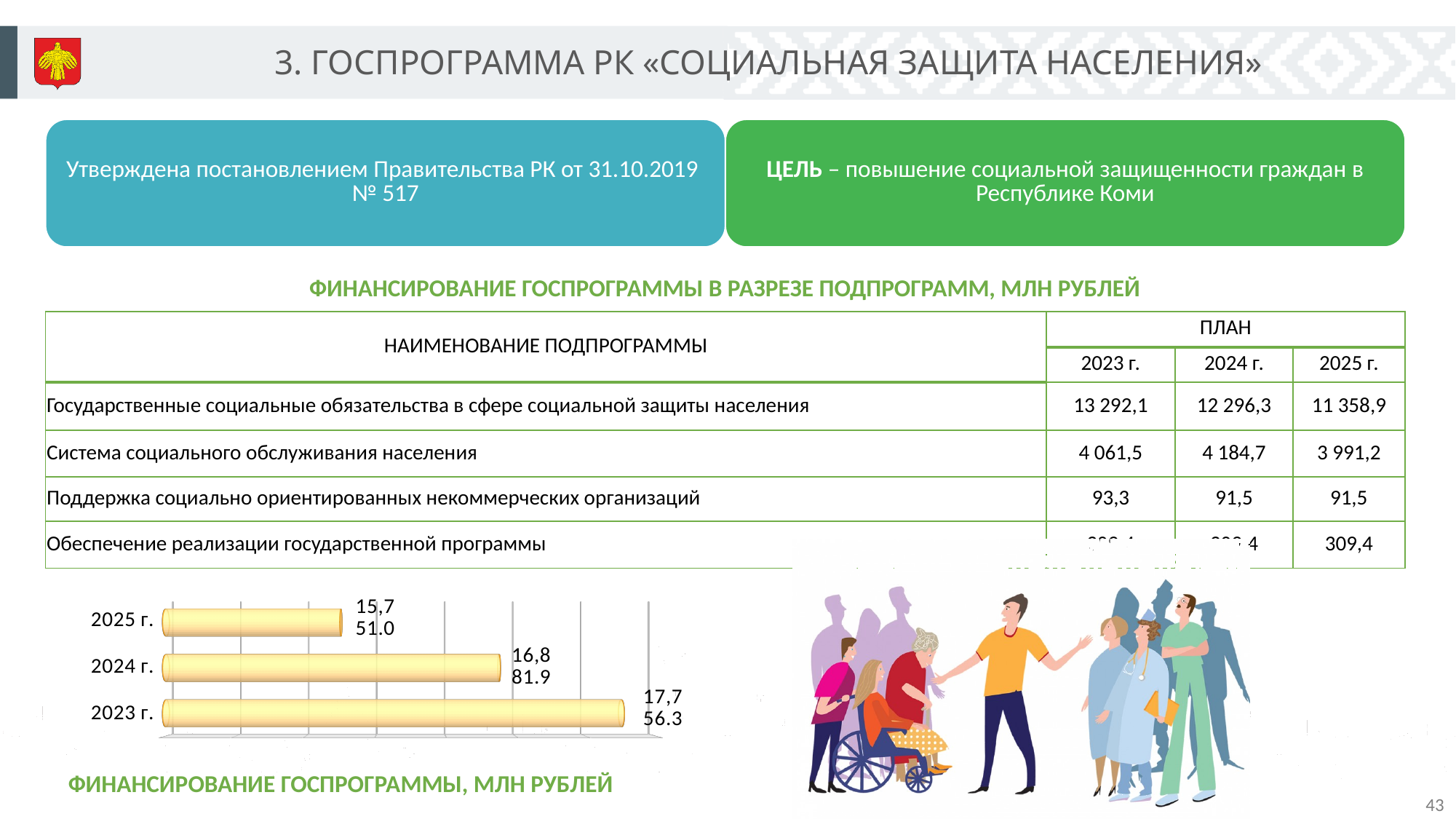
What is the title of the bar chart? ФИНАНСИРОВАНИЕ ГОСПРОГРАММЫ, МЛН РУБЛЕЙ Are the bars in the chart horizontal or vertical? Horizontal Which year has the shortest bar in the chart? 2025 г. Which bar is longer in the chart: 2023 г. or 2024 г.? 2023 г. Which year is listed at the top of the bar chart? 2025 г. What kind of chart is shown at the bottom left of the slide? Bar chart Which year has the longest bar in the chart? 2023 г. Which bar is longer in the chart: 2024 г. or 2025 г.? 2024 г. How many years (categories) are plotted in the bar chart? 3 Do the bar lengths in the chart increase or decrease from 2023 г. to 2025 г.? Decrease